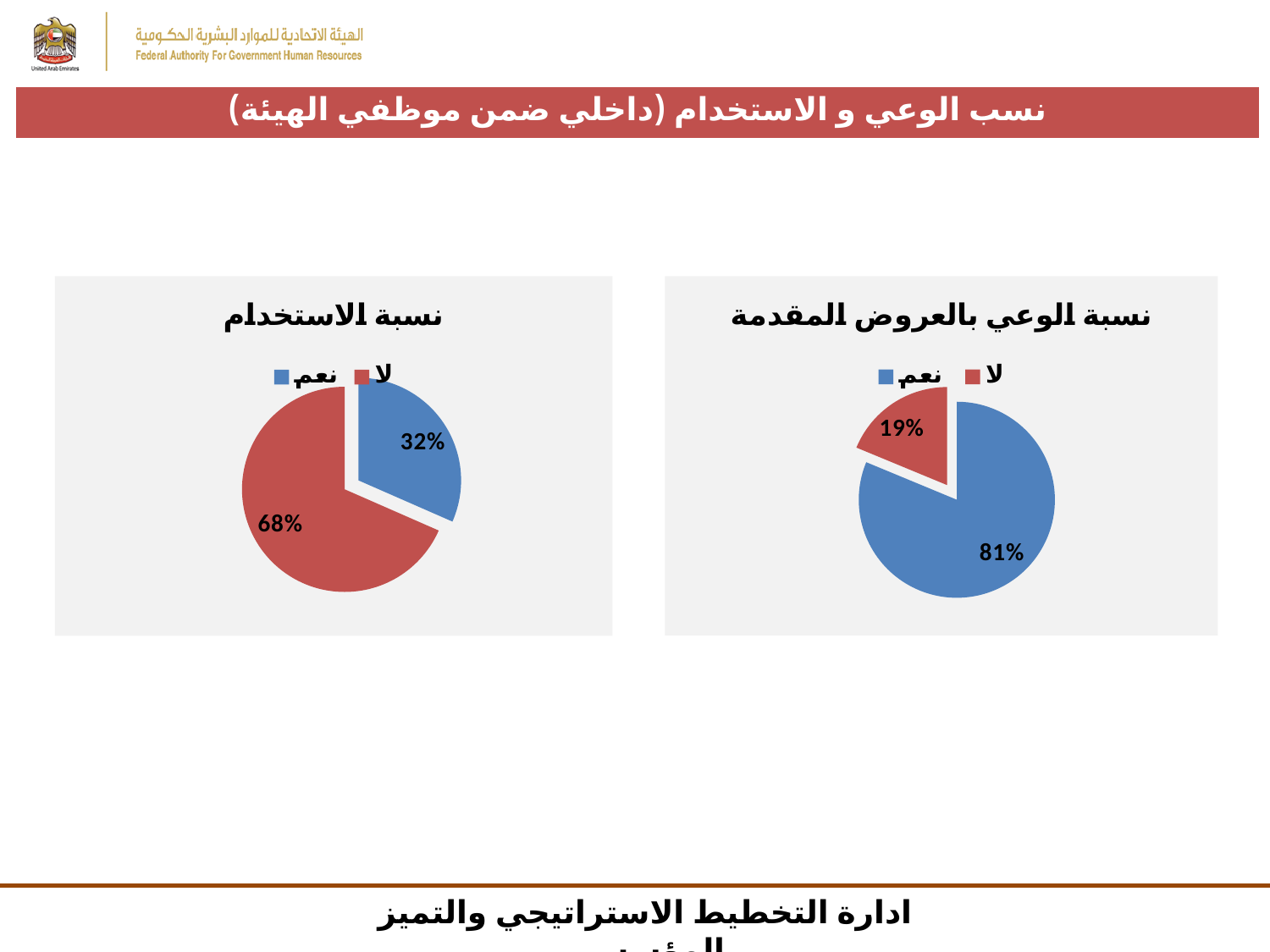
In the left pie chart (نسبة الاستخدام), which category has the largest slice? لا In the pie chart titled "نسبة الاستخدام" (left), what is the share for "لا"? 68% In the right pie chart (نسبة الوعي بالعروض المقدمة), what is the difference between the "نعم" share and the "لا" share? 62% In the right pie chart (نسبة الوعي بالعروض المقدمة), which category has the smallest slice? لا What type of chart is used for "نسبة الاستخدام" on the left? Pie chart Which is larger: the "نعم" share in the right chart (نسبة الوعي بالعروض المقدمة) or the "نعم" share in the left chart (نسبة الاستخدام)? The right chart (نسبة الوعي بالعروض المقدمة) In the pie chart titled "نسبة الوعي بالعروض المقدمة" (right), what is the share for "لا"? 19% In the pie chart titled "نسبة الوعي بالعروض المقدمة" (right), what is the share for "نعم"? 81% How many categories does the legend of the right pie chart (نسبة الوعي بالعروض المقدمة) list? 2 In the pie chart titled "نسبة الاستخدام" (left), what is the share for "نعم"? 32% In the left pie chart (نسبة الاستخدام), what is the difference between the "لا" share and the "نعم" share? 36% In the left pie chart (نسبة الاستخدام), which colour represents "نعم"? Blue